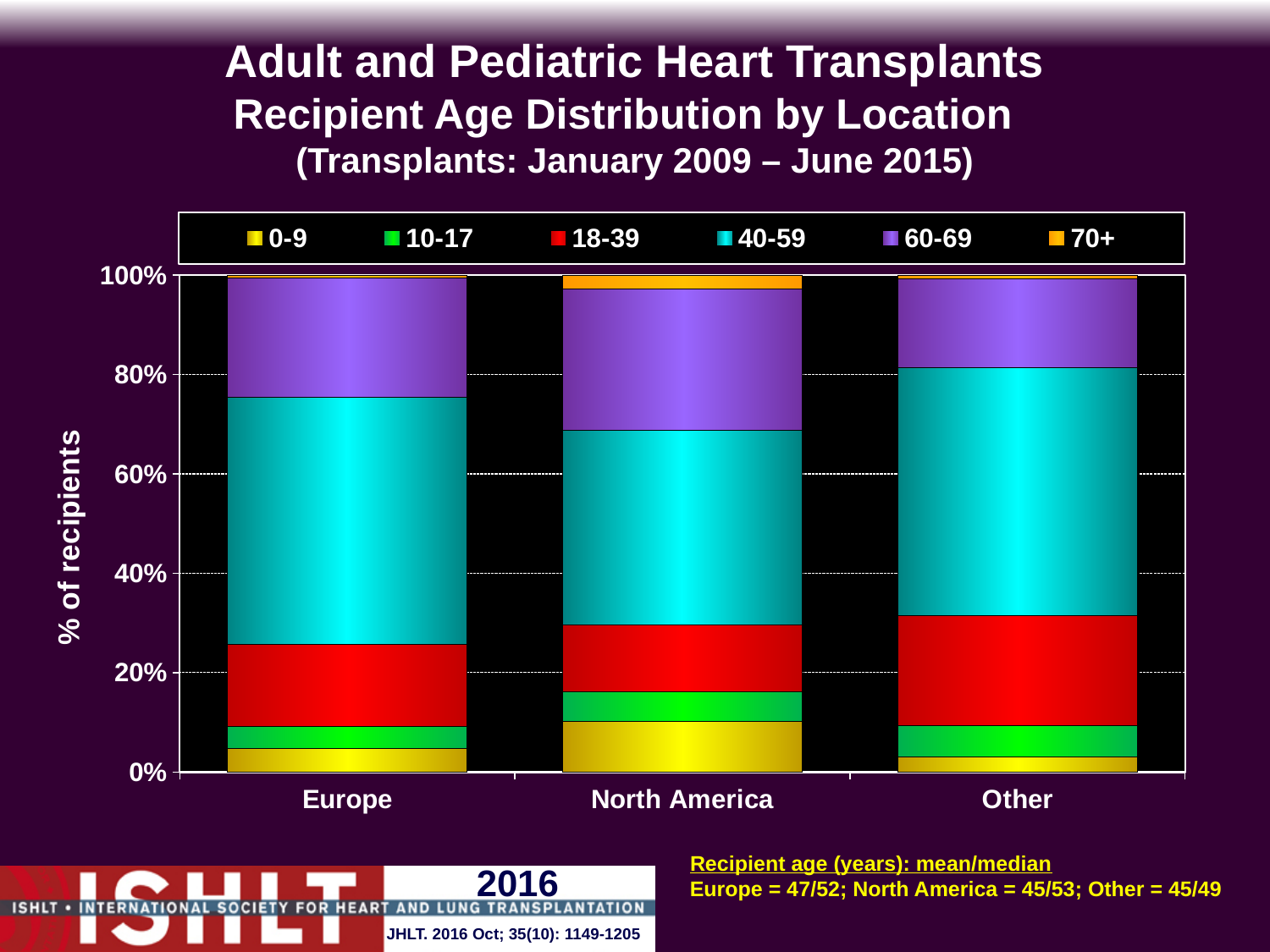
Which age group is shown in yellow in the legend? 0-9 What is the label of the y axis? % of recipients How many locations are shown on the x axis of the chart? 3 How many age groups does the chart legend list? 6 Is the share of recipients aged 60-69 in North America greater or less than 20%? greater Which location has the largest share of recipients aged 18-39? Other Is the share of recipients aged 40-59 in Other greater or less than 40%? greater Is the share of recipients aged 18-39 in Europe greater or less than 20%? less Which location has the largest share of recipients aged 60-69? North America Which location has the largest share of recipients aged 70+? North America What kind of chart is shown on the slide? Stacked bar chart